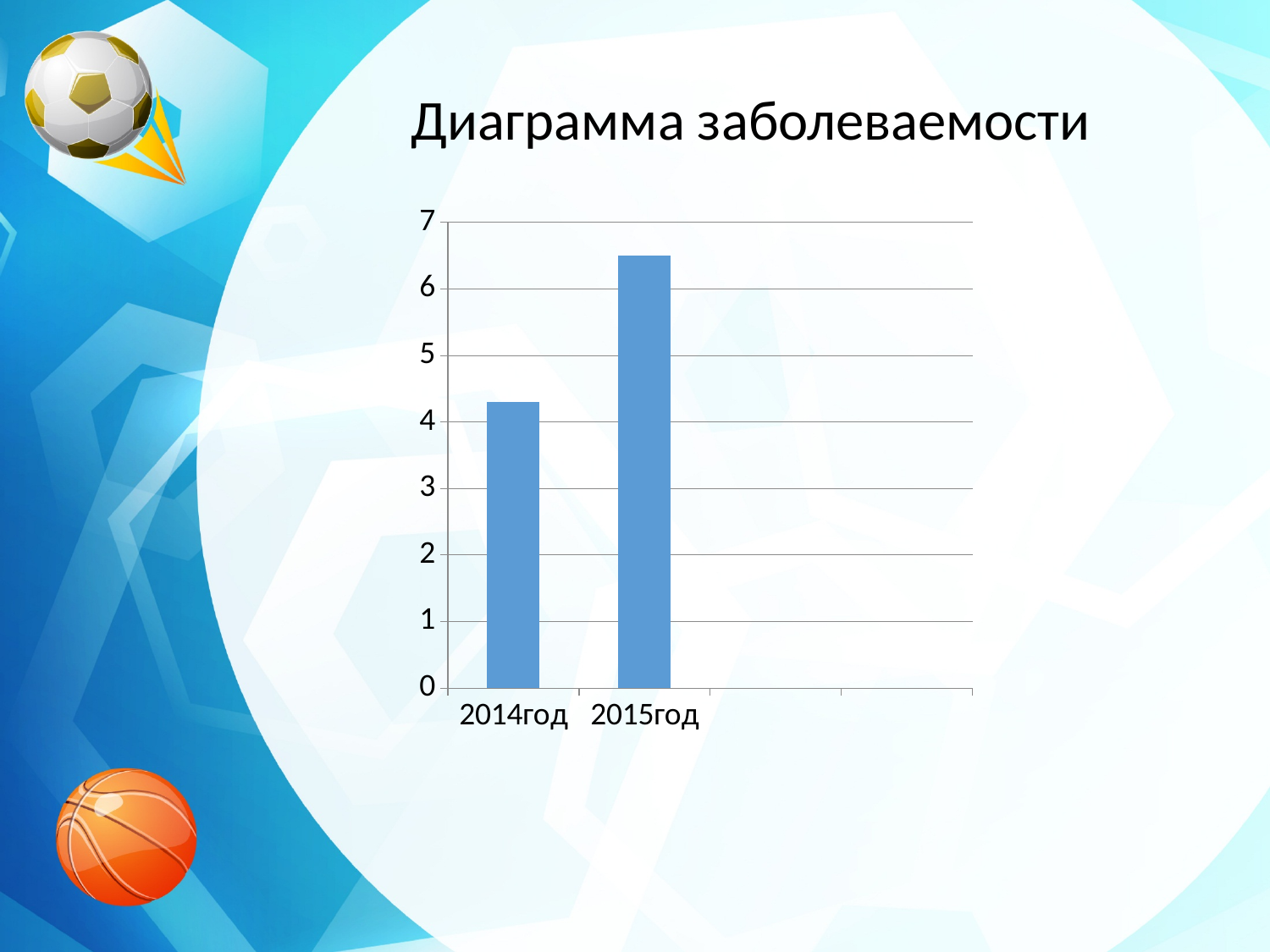
Is the value for 2014год greater or less than 4? greater What kind of chart is shown on the slide? bar chart Is the value for 2015год greater or less than 6? greater Which category has the highest value? 2015год Is the value for 2015год greater or less than 7? less What is the title of the chart? Диаграмма заболеваемости Do the values rise or fall from 2014год to 2015год? rise What is the highest value shown on the vertical axis? 7 How many bars (categories) does the chart show? 2 Which category has the lowest value? 2014год Which is larger, the value for 2014год or the value for 2015год? 2015год